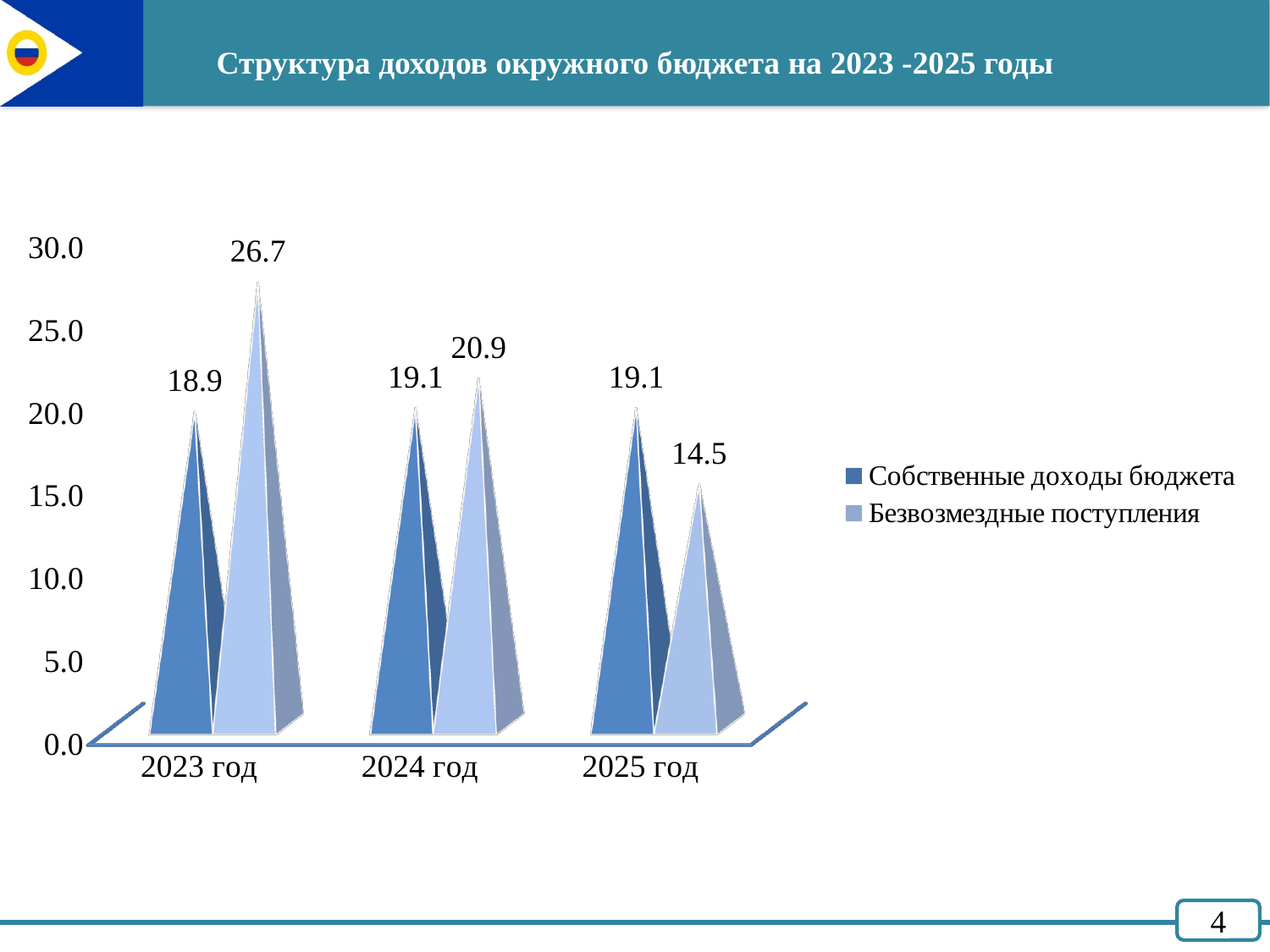
What is the title of the slide? Структура доходов окружного бюджета на 2023 -2025 годы What is the value of Собственные доходы бюджета for 2023 год? 18.9 How many years are shown on the x axis? 3 What is the difference between Собственные доходы бюджета and Безвозмездные поступления in 2025 год? 4.6 What is the value of Безвозмездные поступления for 2025 год? 14.5 In which year is Безвозмездные поступления lowest? 2025 год Which is larger in 2025 год: Собственные доходы бюджета or Безвозмездные поступления? Собственные доходы бюджета Does Безвозмездные поступления rise or fall from 2023 год to 2025 год? fall How many series does the legend list? 2 What is the difference between Безвозмездные поступления and Собственные доходы бюджета in 2023 год? 7.8 In which year is Безвозмездные поступления highest? 2023 год What is the value of Безвозмездные поступления for 2024 год? 20.9